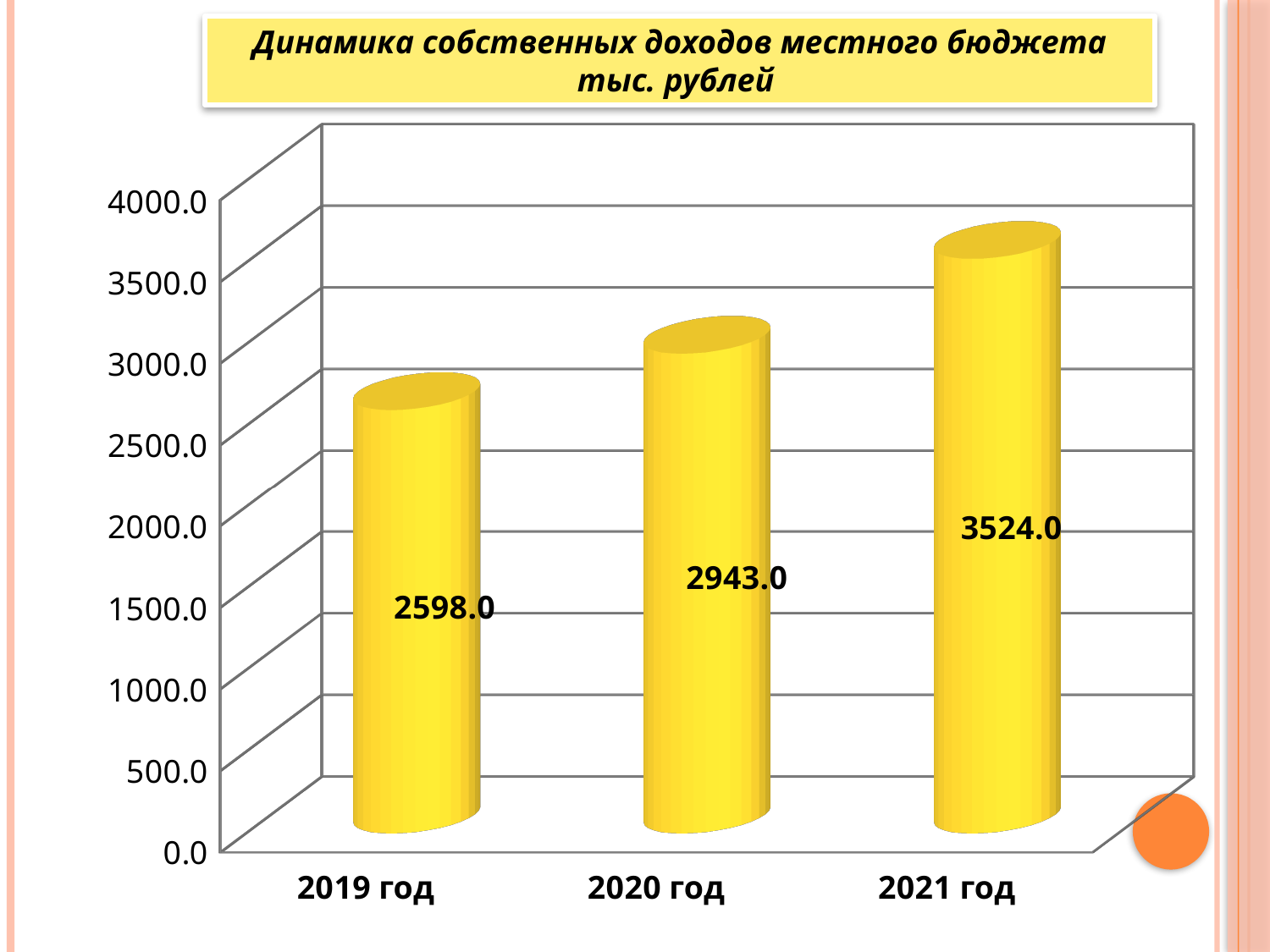
Which is larger, the value for 2020 год or the value for 2021 год? 2021 год Do the values rise or fall from 2019 год to 2021 год? rise What kind of chart is shown on the slide? bar chart What is the value for 2021 год? 3524.0 What is the difference between the values for 2020 год and 2019 год? 345.0 What is the value for 2019 год? 2598.0 How many categories are shown on the x axis? 3 Which year has the lowest value? 2019 год What is the value for 2020 год? 2943.0 Which year has the highest value? 2021 год What is the title of the chart? Динамика собственных доходов местного бюджета тыс. рублей What is the difference between the values for 2021 год and 2019 год? 926.0